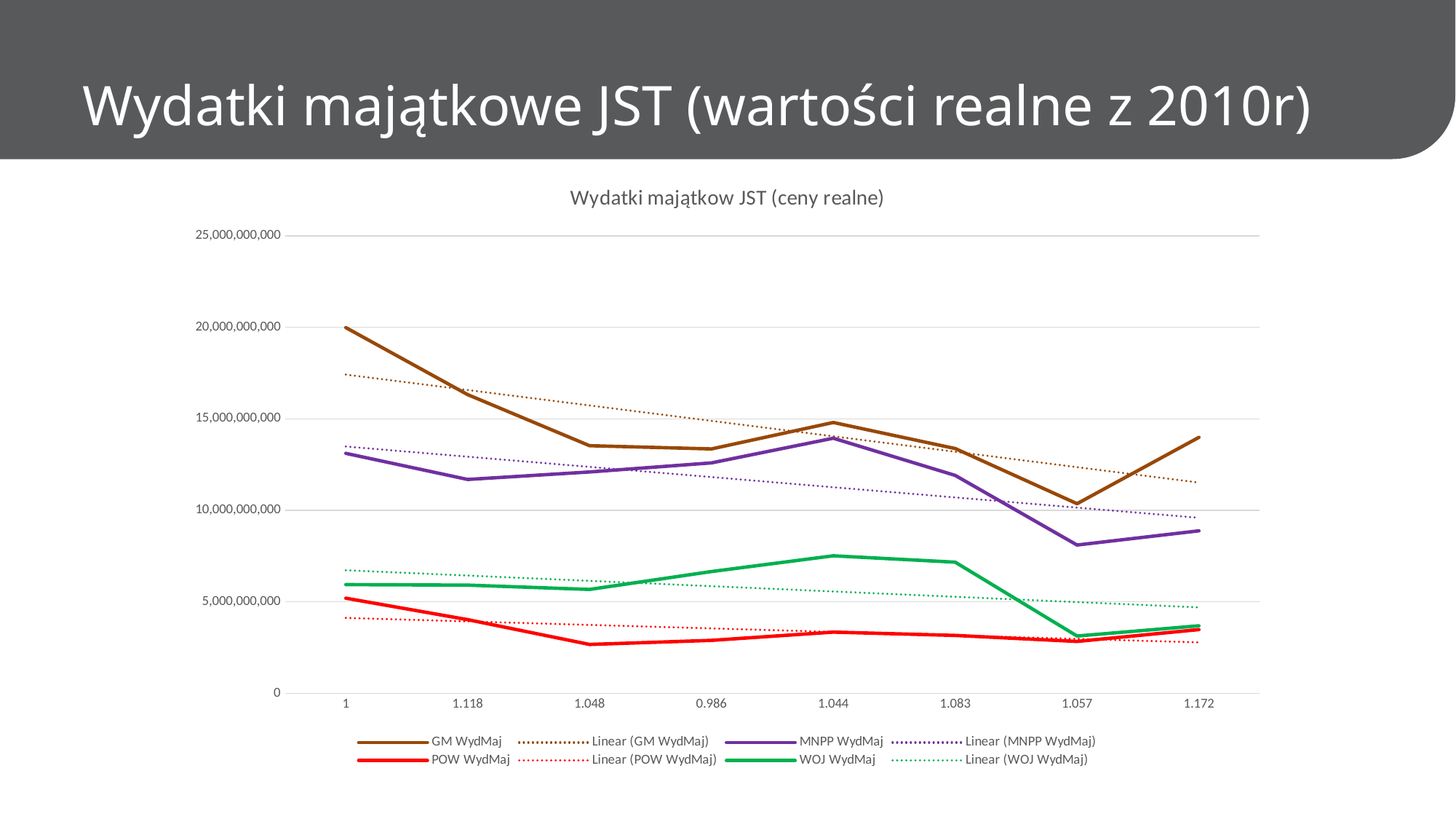
Does the GM WydMaj series rise or fall overall from the first x-axis point to the last? fall What is the title of the chart? Wydatki majątkow JST (ceny realne) How many entries does the chart legend list? 8 How many points are plotted along the x axis for each series? 8 Is the value of GM WydMaj at x = 1.172 greater or less than 15,000,000,000? less Is the value of WOJ WydMaj at x = 1.044 greater or less than 5,000,000,000? greater At x = 1.172, which series has the larger value, GM WydMaj or MNPP WydMaj? GM WydMaj What kind of chart is shown on the slide? line chart Which series has the highest value at the first x-axis point (1)? GM WydMaj At which x-axis point does the MNPP WydMaj series reach its lowest value? 1.057 Which series has the lowest value at the first x-axis point (1)? POW WydMaj Is the value of MNPP WydMaj at x = 1.057 greater or less than 10,000,000,000? less